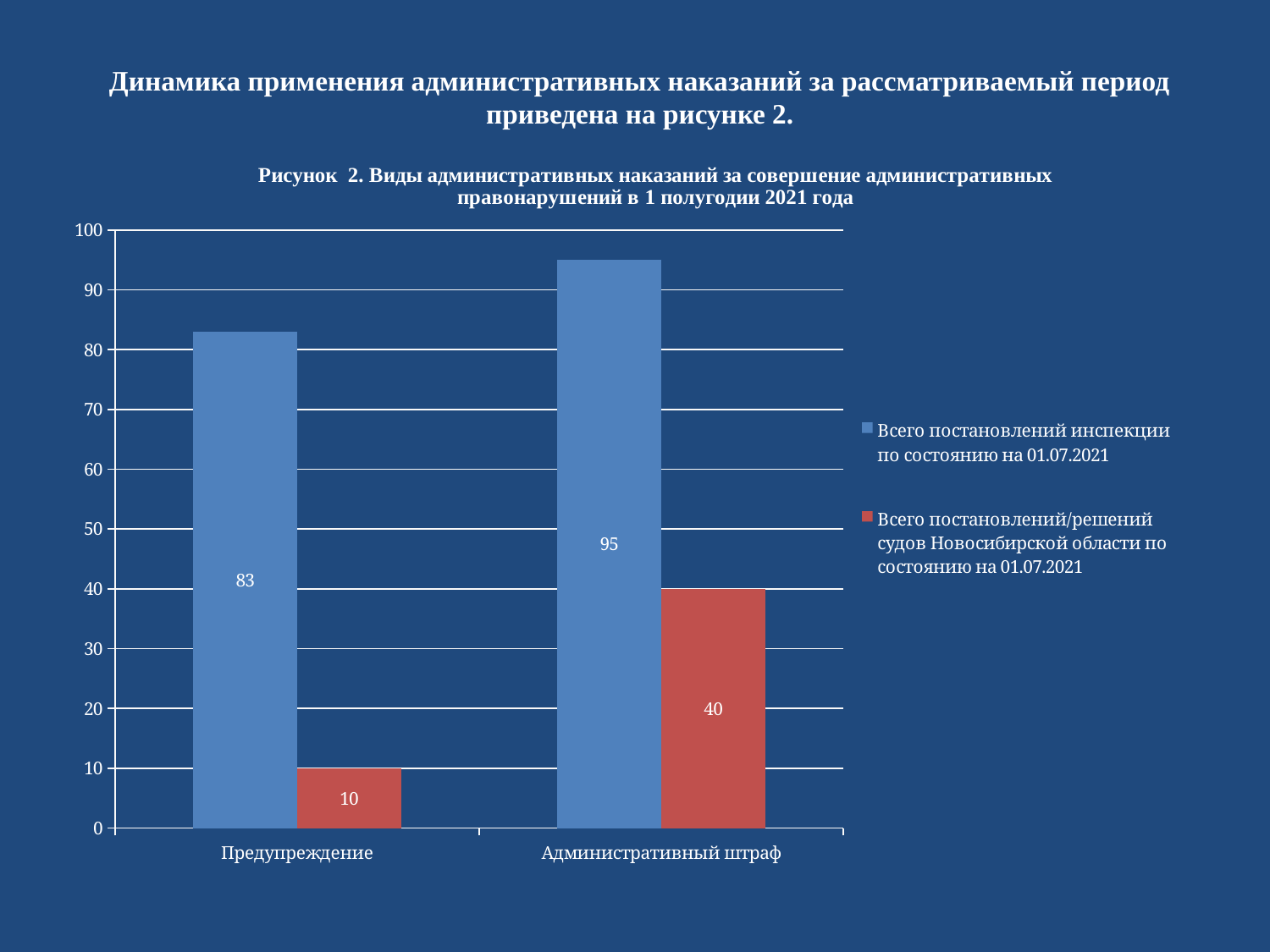
What is the difference between the two series' values for Административный штраф? 55 What is the value for Предупреждение in the series 'Всего постановлений инспекции по состоянию на 01.07.2021'? 83 What is the value for Административный штраф in the series 'Всего постановлений/решений судов Новосибирской области по состоянию на 01.07.2021'? 40 What is the value for Предупреждение in the series 'Всего постановлений/решений судов Новосибирской области по состоянию на 01.07.2021'? 10 How many series does the legend list? 2 Which category has the highest value in the series 'Всего постановлений инспекции по состоянию на 01.07.2021'? Административный штраф How many categories are shown on the x axis? 2 Is the inspection value for Административный штраф greater or less than 90? greater What is the difference between the inspection values for Административный штраф and Предупреждение? 12 What kind of chart is shown on the slide? Bar chart Which is larger: the inspection value for Предупреждение or the court value for Административный штраф? The inspection value for Предупреждение Which category has the lowest value in the series 'Всего постановлений/решений судов Новосибирской области по состоянию на 01.07.2021'? Предупреждение